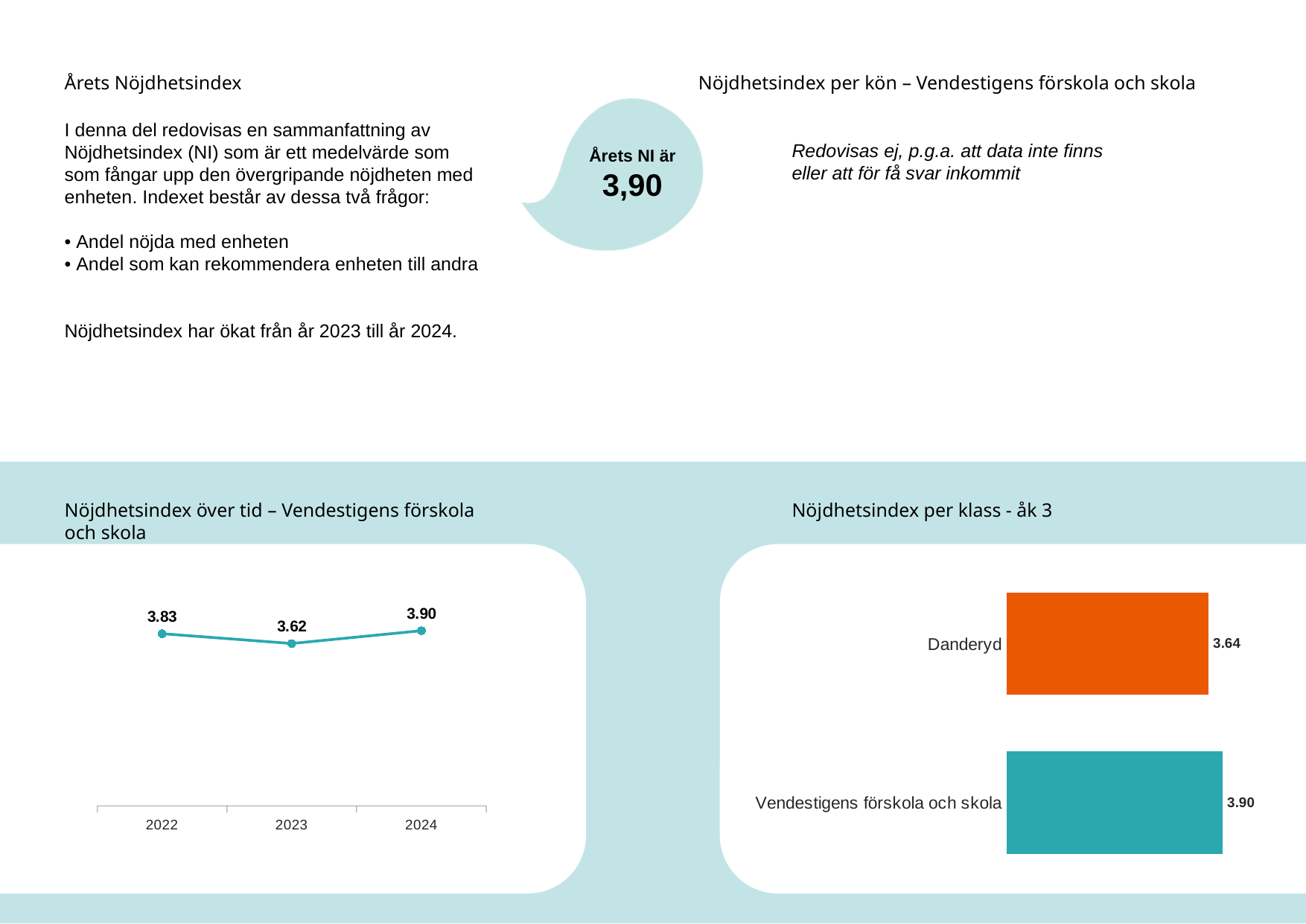
In the 'Nöjdhetsindex per klass - åk 3' chart, what is the value for Danderyd? 3.64 In the 'Nöjdhetsindex över tid – Vendestigens förskola och skola' chart, what is the difference between the 2024 and 2023 values? 0.28 In the 'Nöjdhetsindex över tid – Vendestigens förskola och skola' chart, how many years are plotted? 3 In the 'Nöjdhetsindex över tid – Vendestigens förskola och skola' chart, which year has the highest value? 2024 In the 'Nöjdhetsindex över tid – Vendestigens förskola och skola' chart, which year has the lowest value? 2023 In the 'Nöjdhetsindex över tid – Vendestigens förskola och skola' chart, what is the value for 2023? 3.62 What kind of chart is 'Nöjdhetsindex över tid – Vendestigens förskola och skola'? Line chart In the 'Nöjdhetsindex över tid – Vendestigens förskola och skola' chart, did the value rise or fall from 2023 to 2024? Rise In the 'Nöjdhetsindex över tid – Vendestigens förskola och skola' chart, what is the value for 2022? 3.83 What kind of chart is 'Nöjdhetsindex per klass - åk 3'? Bar chart In the 'Nöjdhetsindex per klass - åk 3' chart, which category has the higher value, Danderyd or Vendestigens förskola och skola? Vendestigens förskola och skola In the 'Nöjdhetsindex per klass - åk 3' chart, what is the difference between Vendestigens förskola och skola and Danderyd? 0.26